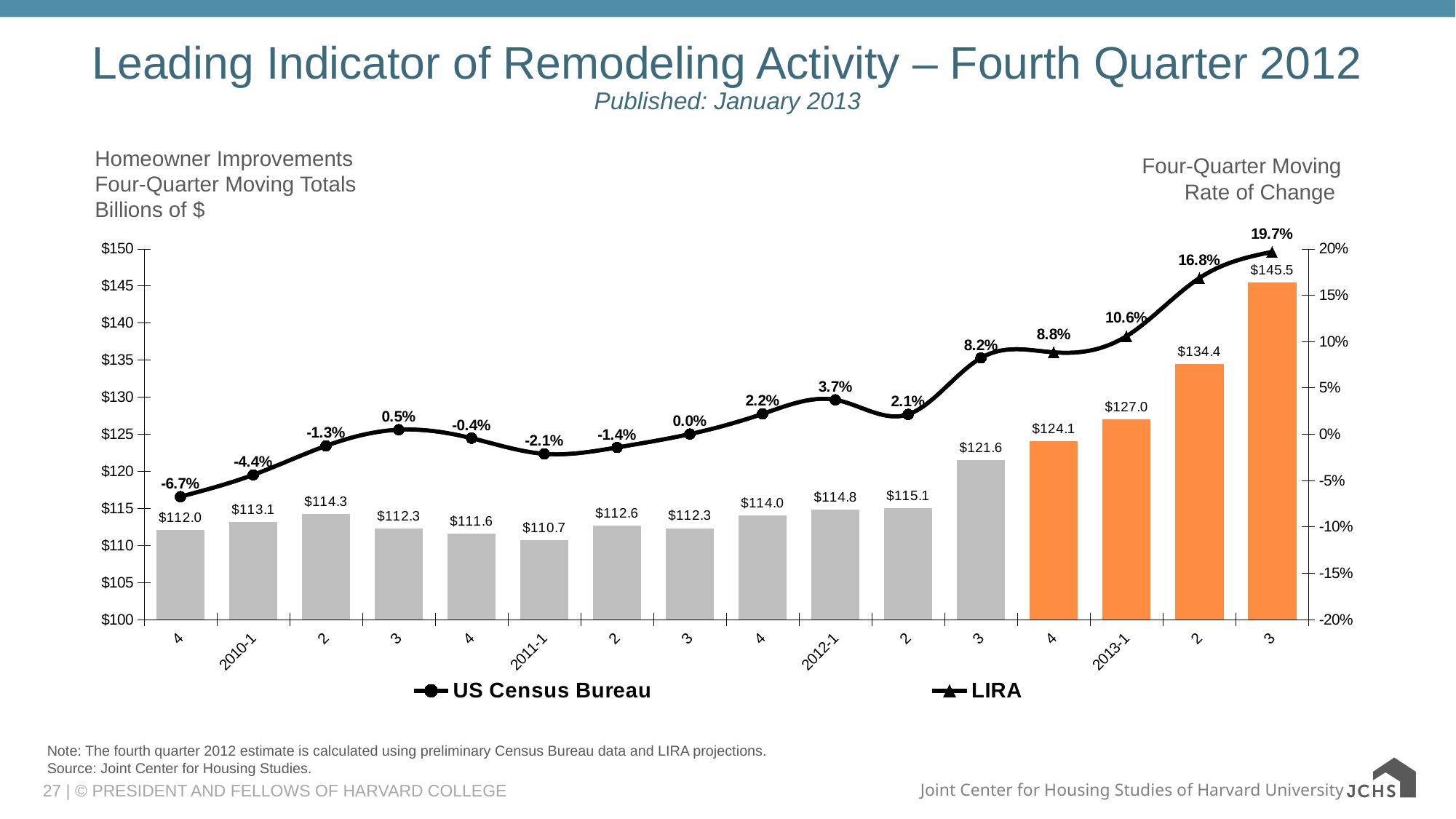
What is the difference between the four-quarter moving totals for 2013 Q3 and 2013 Q2? $11.1 What is the four-quarter moving total for 2013-1? $127.0 Which quarter has the highest four-quarter moving total? 2013 Q3 ($145.5) Which quarter has the lowest four-quarter moving total? 2011-1 ($110.7) How many quarters (bars) are plotted on the chart? 16 What kind of chart is shown on the slide? Combined bar and line chart Is the four-quarter moving total for 2012 Q3 greater or less than $120? greater What is the lowest four-quarter moving rate of change shown on the line? -6.7% Does the four-quarter moving rate of change rise or fall from 2012 Q3 to 2013 Q3? Rises What is the four-quarter moving rate of change for 2012-1? 3.7% Which is larger, the four-quarter moving total for 2010 Q2 or for 2012-1? 2012-1 How many series does the legend list? 2